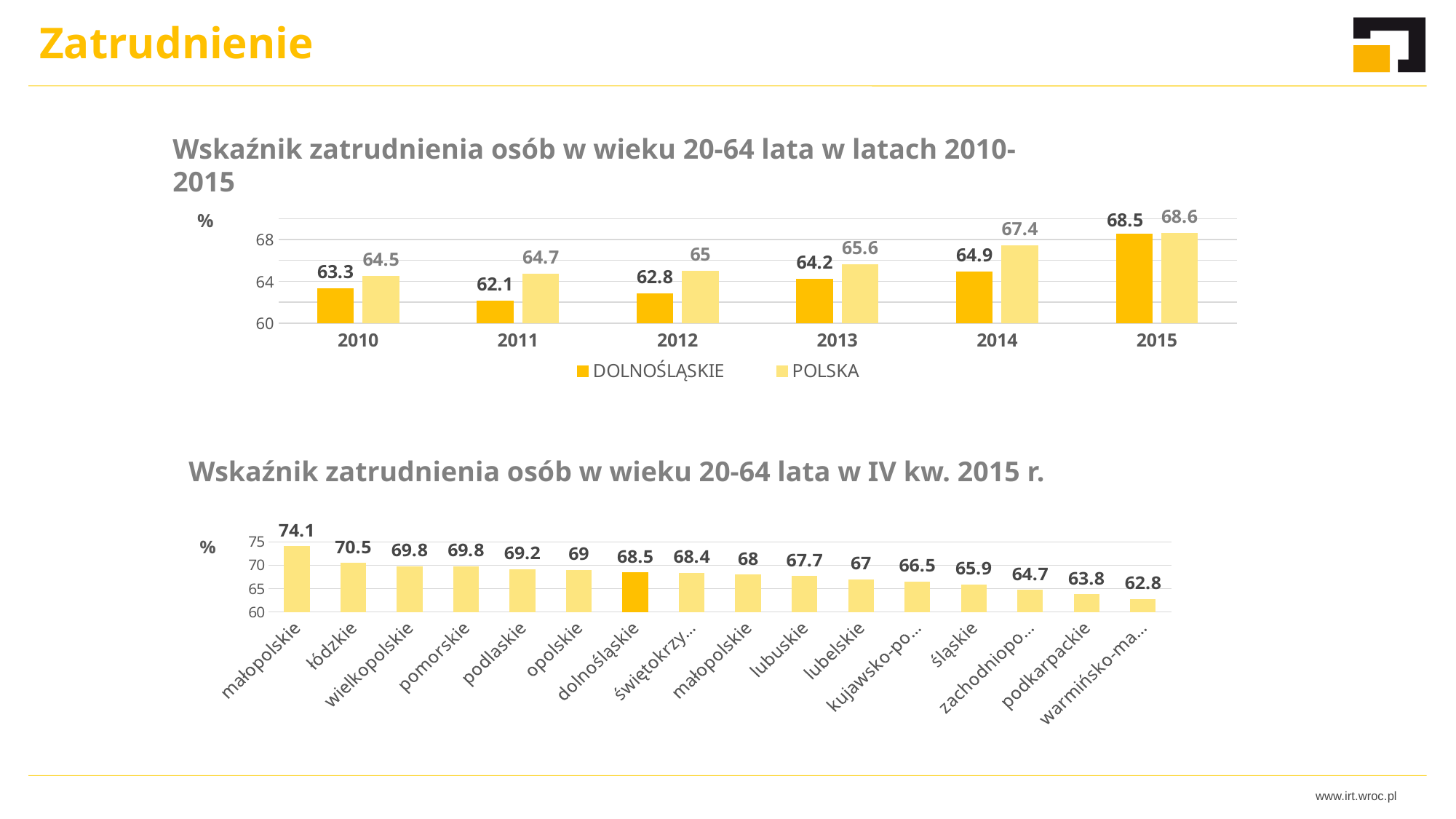
In the top chart, do the DOLNOŚLĄSKIE values rise or fall from 2011 to 2015? rise In the top chart, how many series does the legend list? 2 In the bottom chart, what is the difference between the values for łódzkie and podkarpackie? 6.7 In the top chart, which is larger in 2013: DOLNOŚLĄSKIE or POLSKA? POLSKA In the top chart, in which year is the DOLNOŚLĄSKIE value lowest? 2011 In the top chart, what is the value for POLSKA in 2014? 67.4 What kind of chart is the bottom chart? bar chart In the top chart, what is the difference between the POLSKA and DOLNOŚLĄSKIE values in 2011? 2.6 In the bottom chart, what is the value for łódzkie? 70.5 In the bottom chart (Wskaźnik zatrudnienia osób w wieku 20-64 lata w IV kw. 2015 r.), what is the value for dolnośląskie? 68.5 In the bottom chart, which region has the lowest value? warmińsko-mazurskie In the top chart (Wskaźnik zatrudnienia osób w wieku 20-64 lata w latach 2010-2015), what is the value for DOLNOŚLĄSKIE in 2012? 62.8